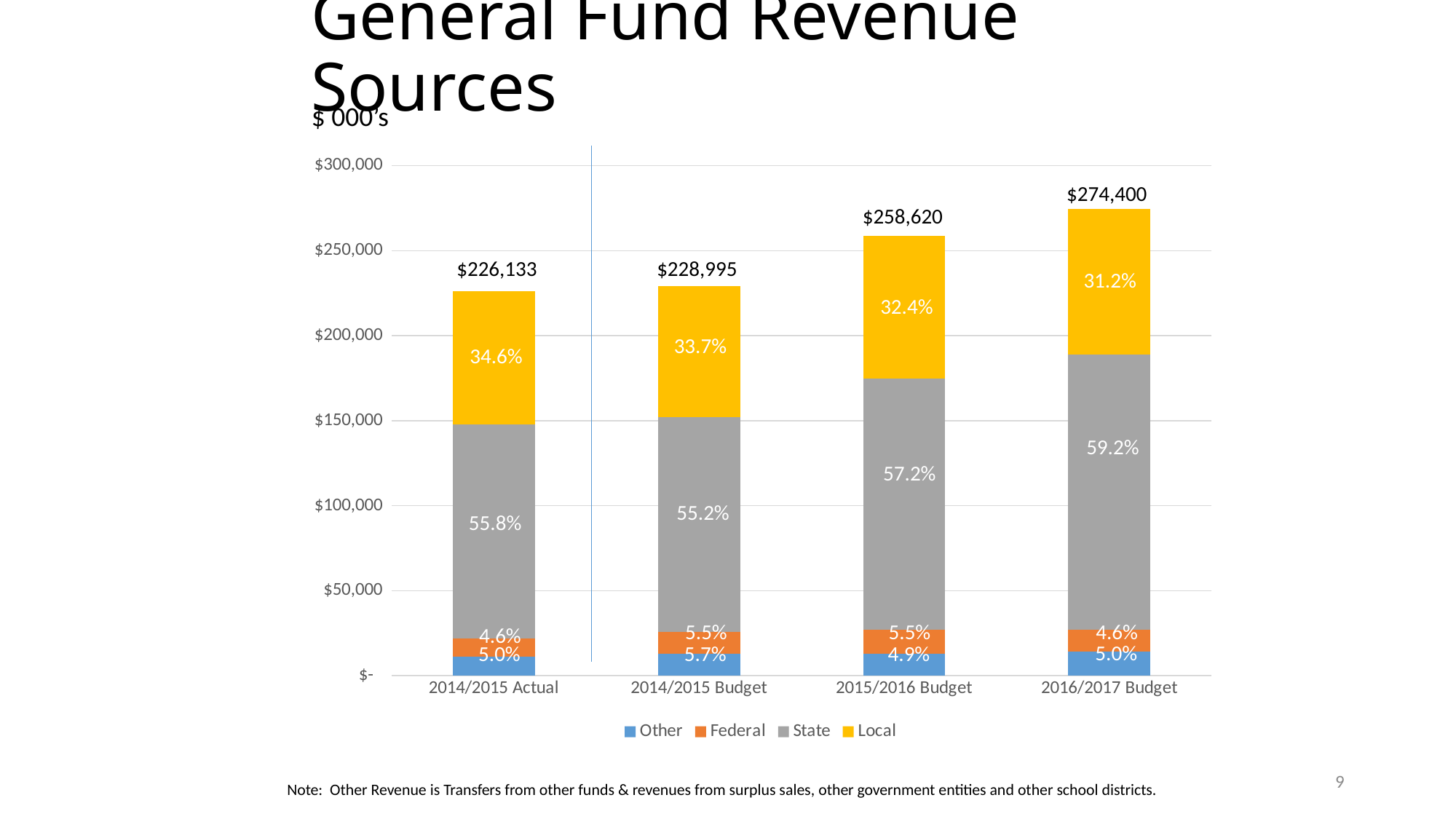
Which has a larger Local share, 2014/2015 Actual or 2016/2017 Budget? 2014/2015 Actual How many series does the legend list? 4 What is the difference between the total for the 2016/2017 Budget and the total for the 2014/2015 Actual? $48,267 Which category has the lowest total revenue? 2014/2015 Actual Do the total revenue values rise or fall from left to right across the x axis? rise Which category has the highest total revenue? 2016/2017 Budget How many categories are shown along the x axis of the chart? 4 Is the total for the 2014/2015 Budget greater or less than $250,000? less What kind of chart is shown on the slide? bar chart What percentage of revenue comes from Federal in the 2014/2015 Budget? 5.5% What is the total General Fund revenue shown for the 2015/2016 Budget? $258,620 What percentage of revenue comes from State in the 2016/2017 Budget? 59.2%